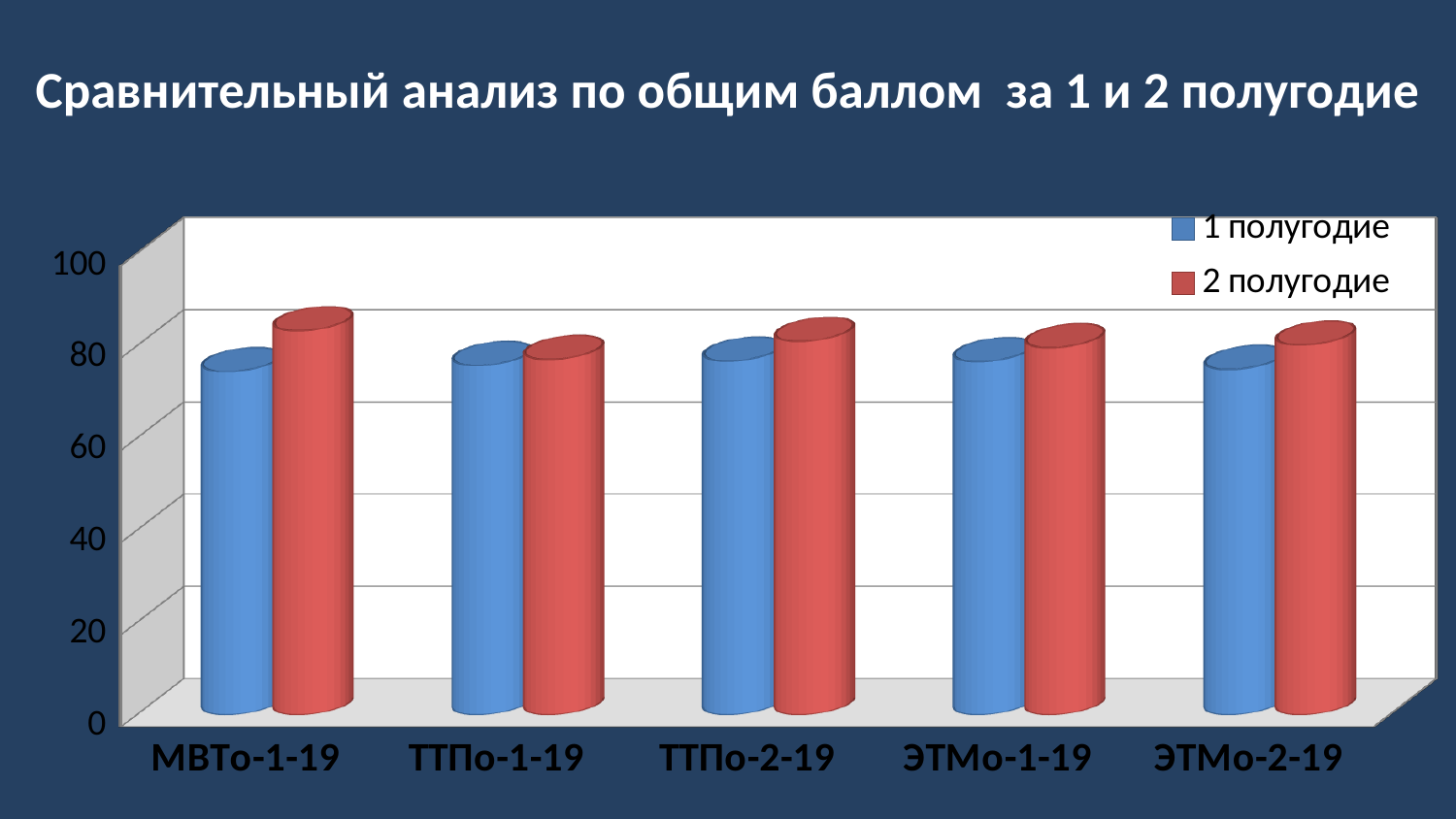
For ЭТМо-2-19, which is larger: the value for "1 полугодие" or "2 полугодие"? 2 полугодие What kind of chart is shown on the slide? bar chart What is the title of the chart on the slide? Сравнительный анализ по общим баллом за 1 и 2 полугодие How many categories are shown on the x axis of the chart? 5 Which colour represents the series "2 полугодие" in the chart? red Which category has the highest value for "2 полугодие"? МВТо-1-19 Is the value for "2 полугодие" for МВТо-1-19 greater or less than 100? less Is the value for "1 полугодие" for МВТо-1-19 greater or less than 60? greater Is the value for "2 полугодие" for ТТПо-1-19 greater or less than 100? less How many series does the chart's legend list? 2 For МВТо-1-19, which is larger: the value for "1 полугодие" or "2 полугодие"? 2 полугодие